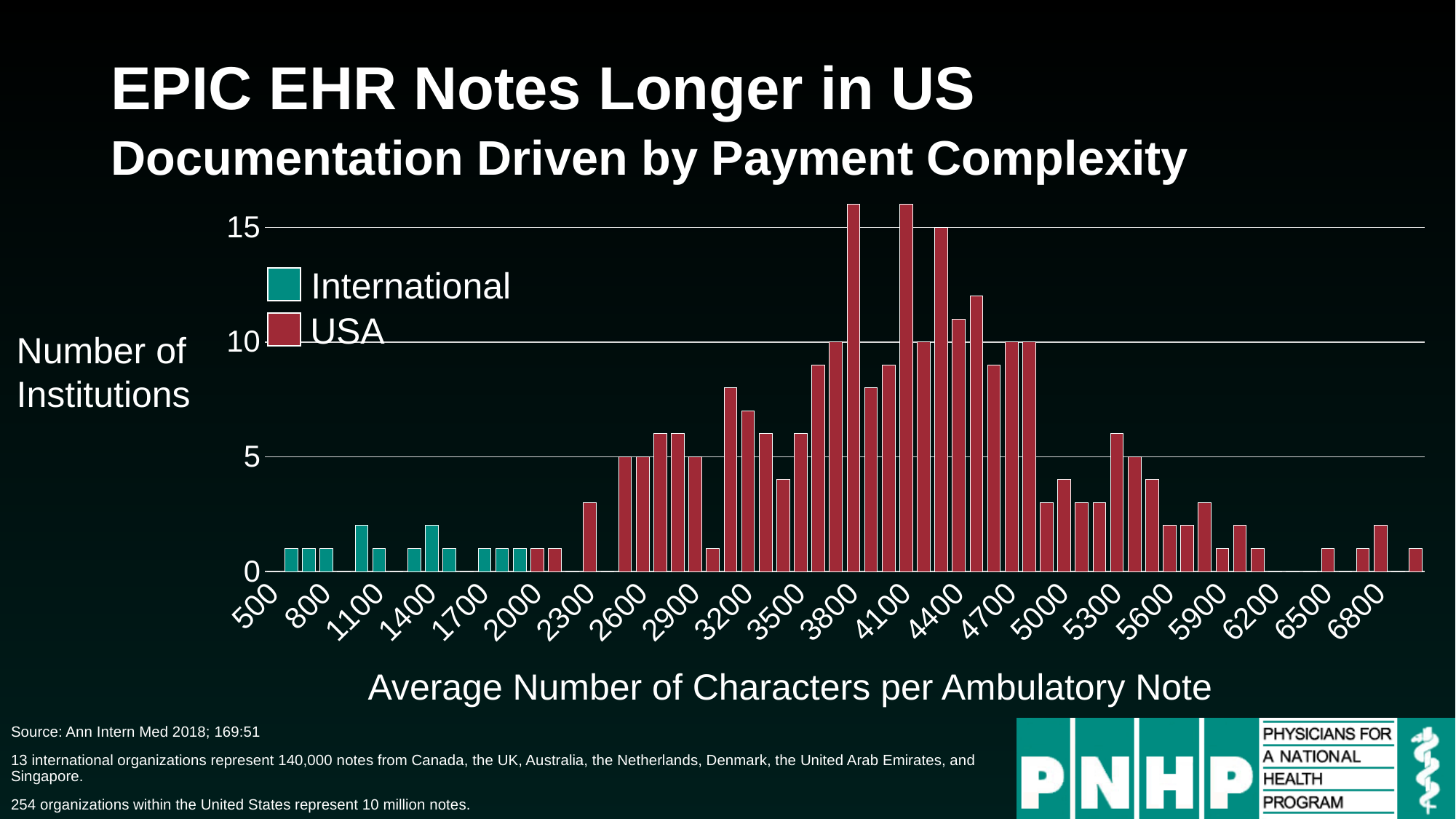
Do the USA bars generally rise or fall as the character count increases from 4400 toward 6800? fall Is the tallest International bar greater or less than 5? less Do the USA bars generally rise or fall as the character count increases from 2300 toward 3800? rise Is the tallest USA bar greater or less than 15? greater Which series has the tallest bars, International or USA? USA How many tick labels are shown along the x axis? 22 Which series has its bars at the lower end of the character-count axis, International or USA? International What is the highest value shown on the y axis? 15 What is the label on the x axis of the chart? Average Number of Characters per Ambulatory Note What kind of chart is shown on the slide? Bar chart What are the two series named in the legend? International and USA How many series does the legend list? 2